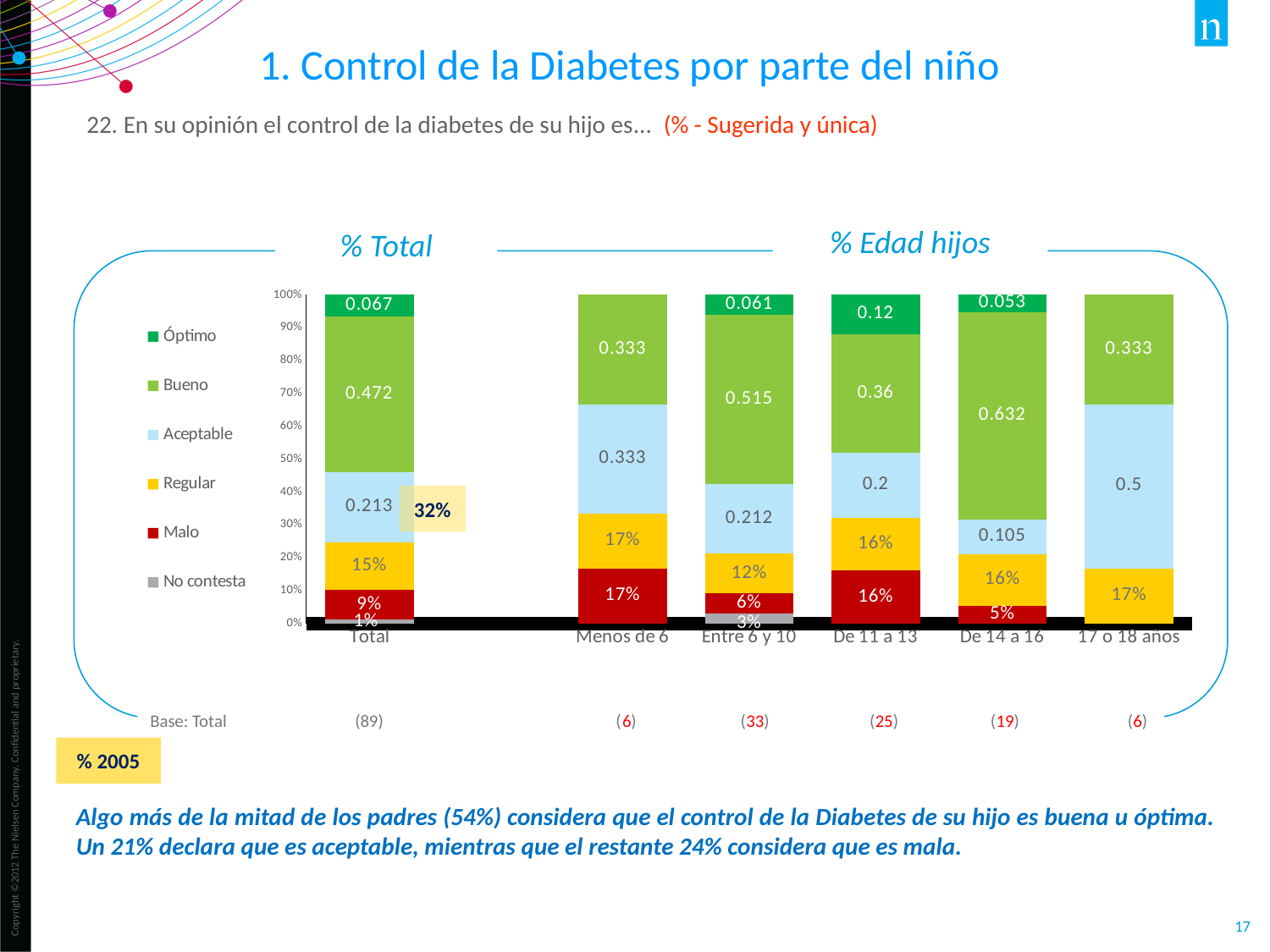
What is the data label for the Bueno segment of the Total bar? 0.472 How many categories are shown along the x axis of the chart? 6 How many series does the legend list? 6 What is the data label for the Regular segment of the De 14 a 16 bar? 16% What kind of chart is shown on the slide? Stacked bar chart What is the data label for the Aceptable segment of the 17 o 18 años bar? 0.5 Which category has the smallest Malo segment among those with a Malo label? De 14 a 16 What is the data label for the Malo segment of the Entre 6 y 10 bar? 6% Which category has the largest Bueno segment? De 14 a 16 Which is larger, the Malo segment for Menos de 6 or for Entre 6 y 10? Menos de 6 What is the difference between the Regular segment for Menos de 6 and for Entre 6 y 10? 5% What is the data label for the Óptimo segment of the De 11 a 13 bar? 0.12